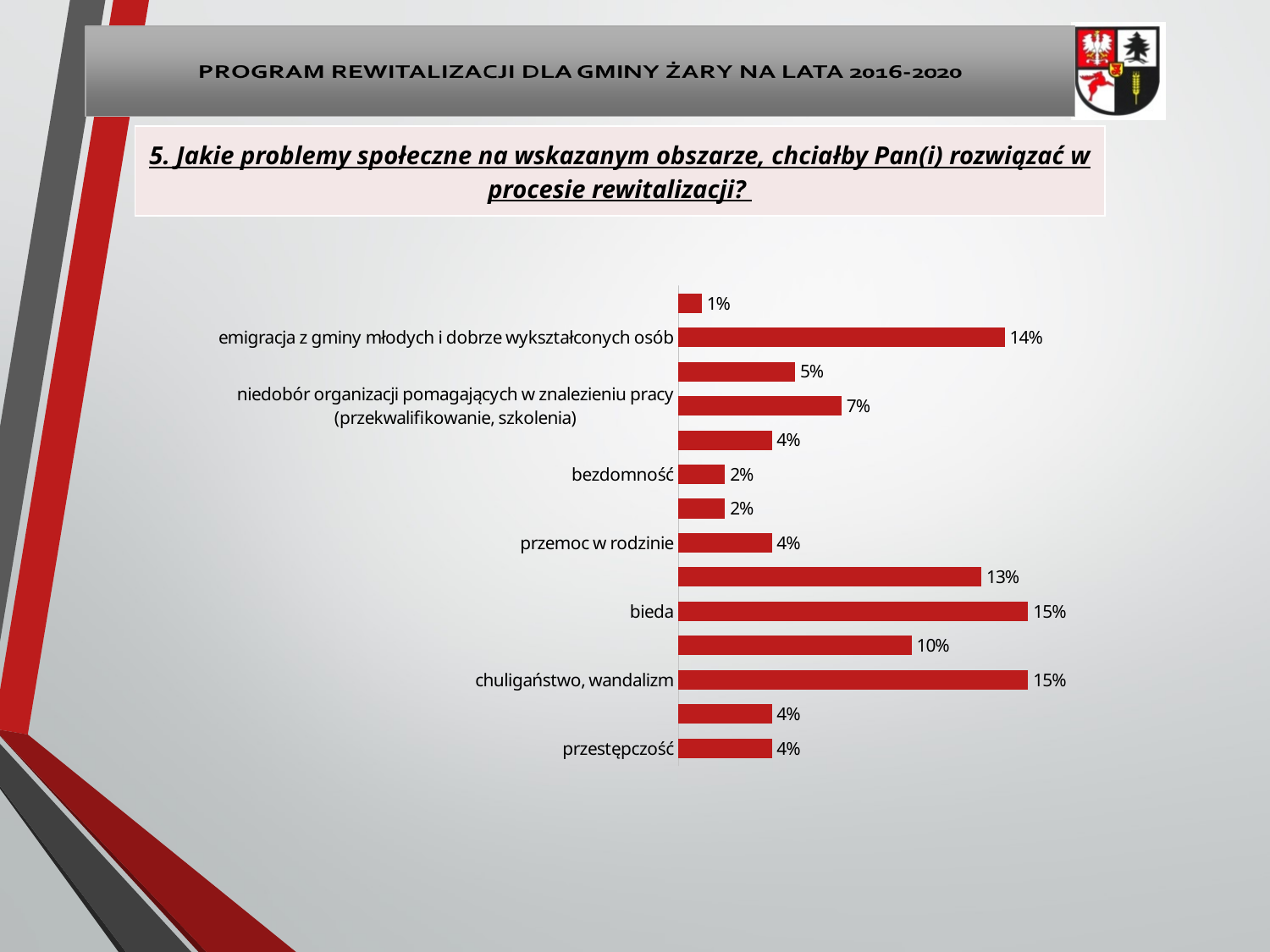
What kind of chart is shown on the slide? bar chart How many bars are plotted in the chart? 14 What is the highest value shown by any bar in the chart? 15% What is the value for "bezdomność"? 2% Which is larger, the value for "emigracja z gminy młodych i dobrze wykształconych osób" or the value for "niedobór organizacji pomagających w znalezieniu pracy (przekwalifikowanie, szkolenia)"? emigracja z gminy młodych i dobrze wykształconych osób What is the value for "przestępczość"? 4% What is the value for "emigracja z gminy młodych i dobrze wykształconych osób"? 14% What is the value for "bieda"? 15% What is the value for "niedobór organizacji pomagających w znalezieniu pracy (przekwalifikowanie, szkolenia)"? 7% What is the value for "chuligaństwo, wandalizm"? 15% What is the value for "przemoc w rodzinie"? 4% What is the lowest value shown by any bar in the chart? 1%